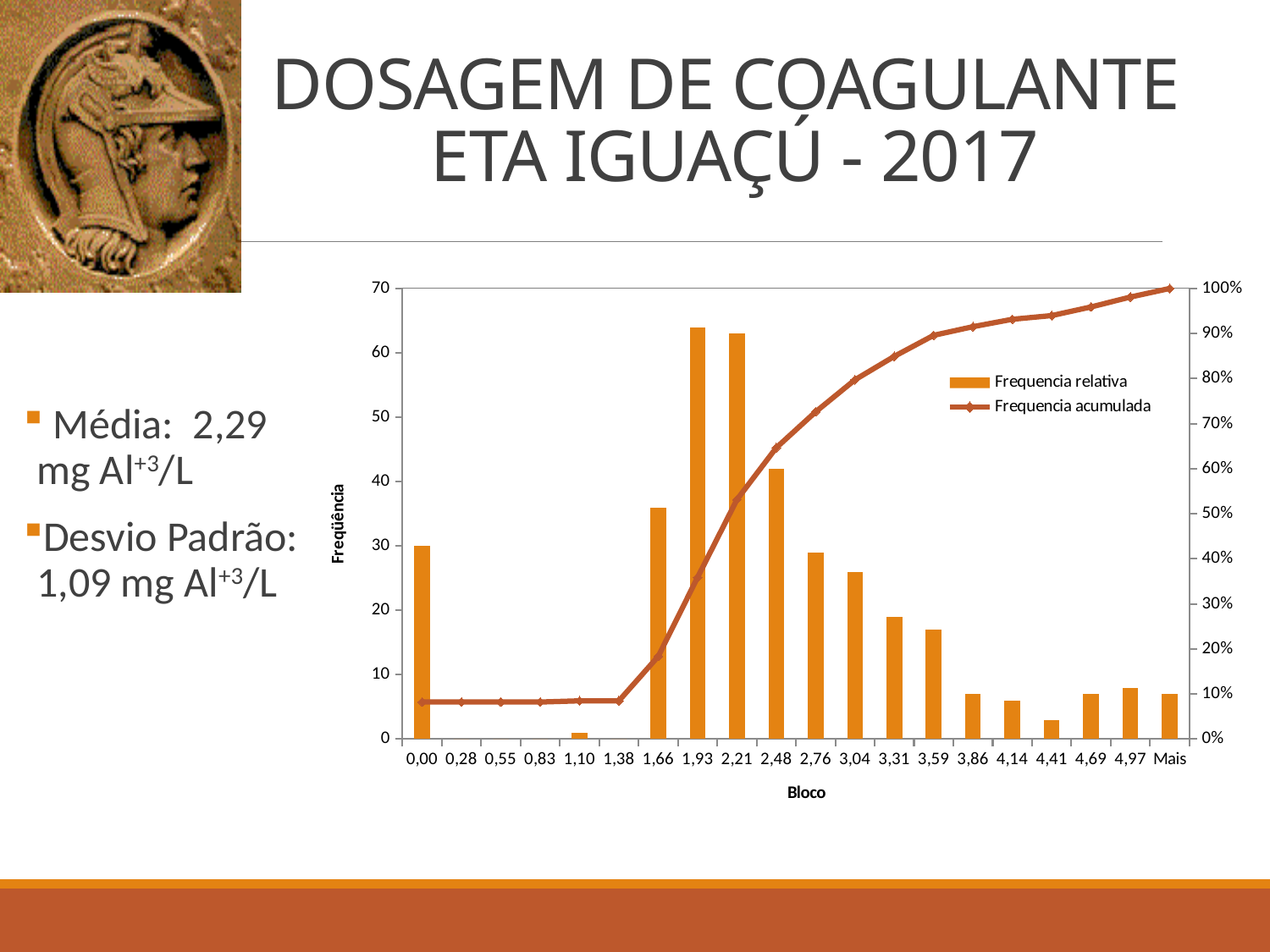
How many categories are shown along the x axis (Bloco) of the chart? 20 How many series does the chart legend list? 2 Which bloco has the larger Frequencia relativa bar, 1,66 or 2,48? 2,48 Is the Frequencia relativa bar for bloco 1,93 greater or less than 60? greater Does the Frequencia acumulada line rise or fall as the bloco values increase along the x axis? rise What are the two series named in the chart legend? Frequencia relativa and Frequencia acumulada Is the Frequencia acumulada value at bloco 2,21 greater or less than 50%? greater What kind of chart is shown on the slide? A combination bar and line chart What is the title of the chart's vertical axis on the left? Freqüência What Frequencia acumulada value does the line reach at the 'Mais' category? 100% Is the Frequencia relativa bar for bloco 2,48 greater or less than 50? less